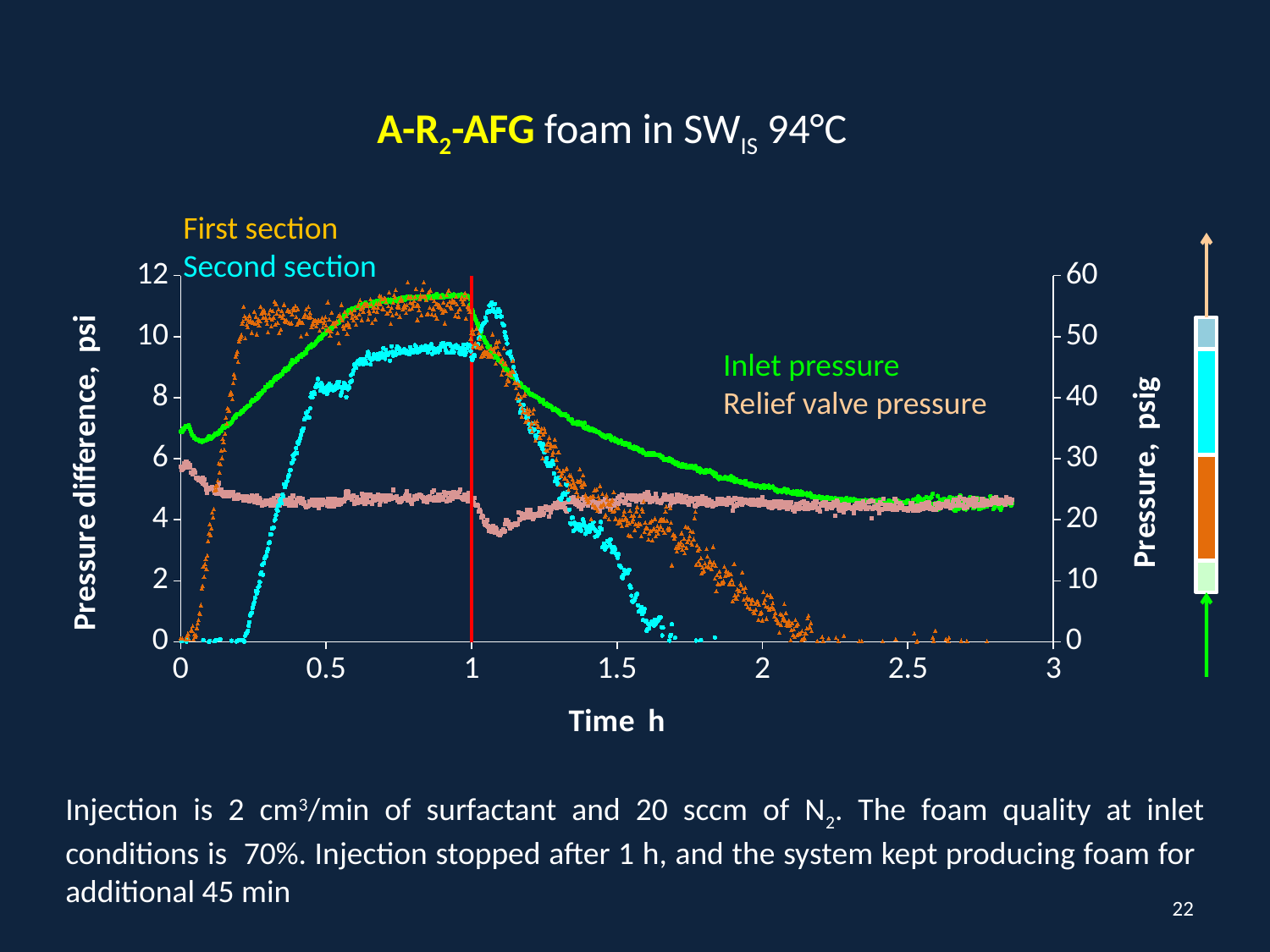
Is the Second section pressure difference at 2 h greater or less than 2 psi? less What kind of chart is shown on the slide? scatter chart Is the Inlet pressure at 2.5 h greater or less than 30 psig? less Is the Second section pressure difference at 0.5 h greater or less than 10 psi? less Does the Second section pressure difference rise or fall between 0.25 h and 0.75 h? rise Does the Inlet pressure rise or fall between 1 h and 2.5 h? fall At what time is the red vertical line drawn on the chart? 1 How many data series are labelled on the chart? 4 Does the First section pressure difference rise or fall between 1.5 h and 2 h? fall What is the label of the left vertical axis? Pressure difference, psi